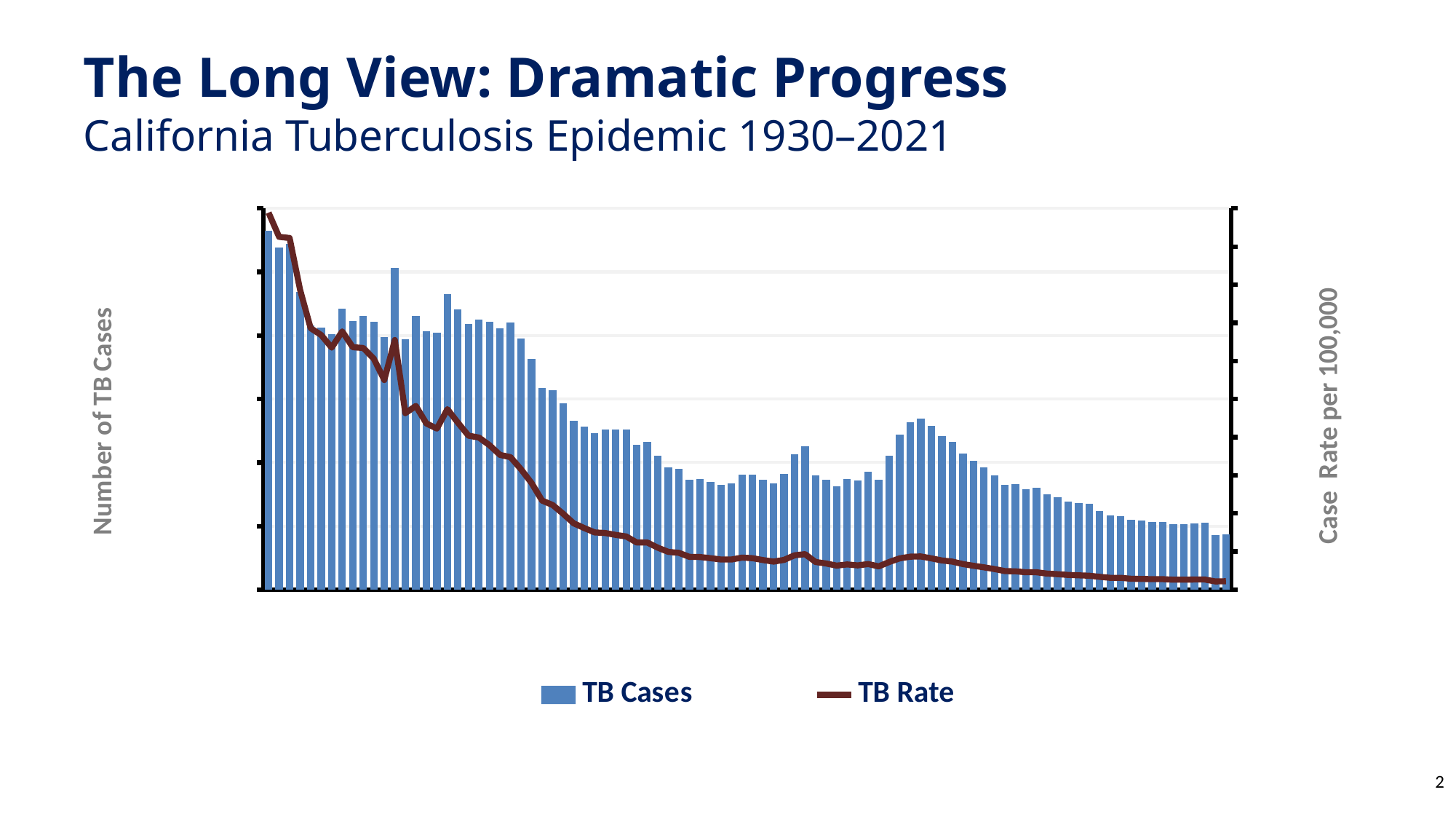
What is the title of the right vertical axis? Case Rate per 100,000 Which series is drawn as bars? TB Cases Does the TB Rate line rise or fall overall from left to right across the chart? Fall Which series is drawn as a line rather than as bars? TB Rate Do the TB Cases bars generally rise or fall from the left side of the chart to the right side? Fall What kind of chart is shown on the slide? A bar chart with a line overlaid How many series does the chart's legend list? 2 What is the title of the left vertical axis? Number of TB Cases